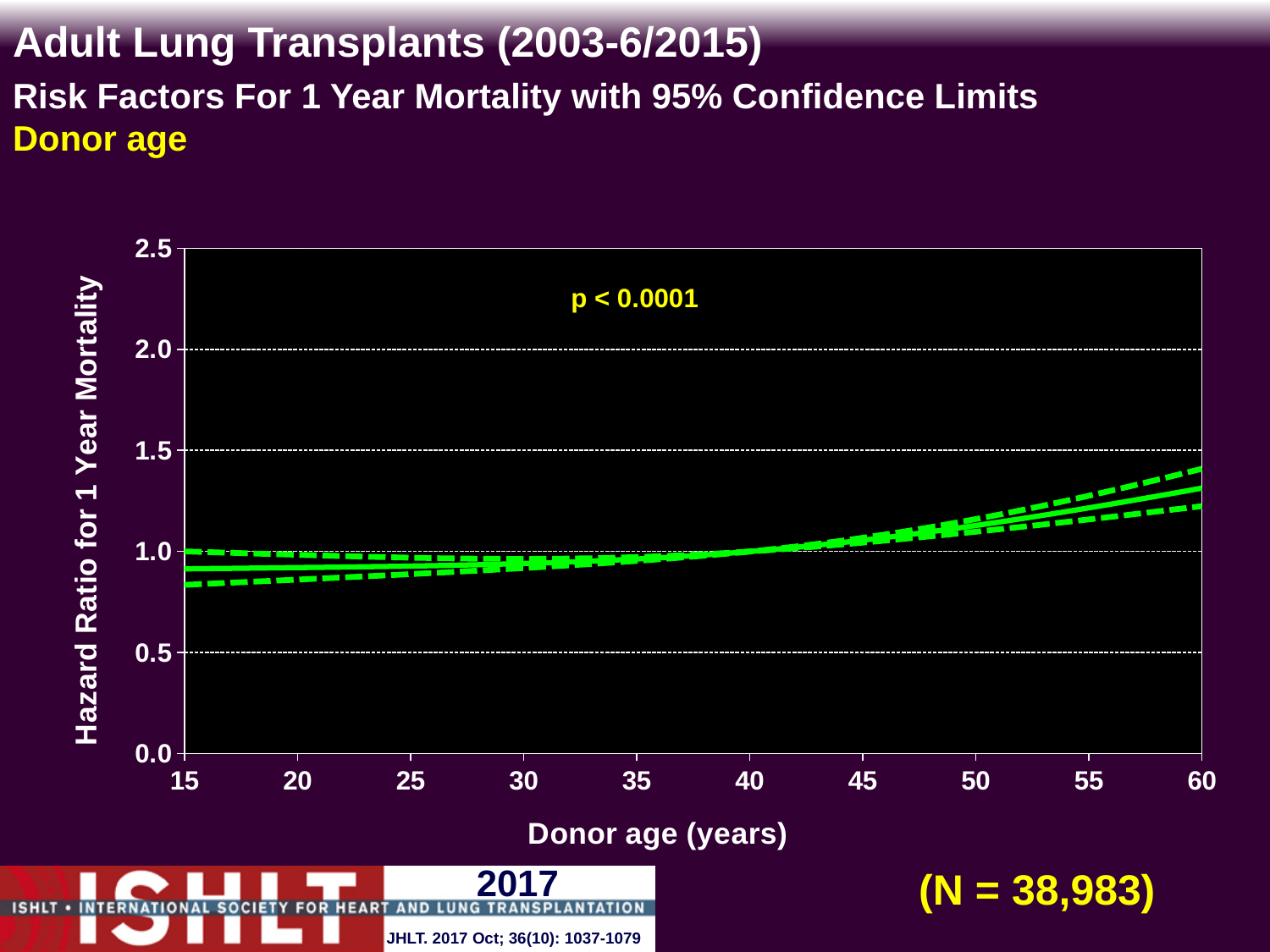
What is the label of the x axis of the chart? Donor age (years) Is the hazard ratio for 1 year mortality at a donor age of 60 years greater or less than 1.0? greater Is the hazard ratio for 1 year mortality at a donor age of 15 years greater or less than 1.0? less Does the hazard ratio for 1 year mortality rise or fall as donor age increases from 15 to 60 years? rise Is the hazard ratio for 1 year mortality at a donor age of 55 years greater or less than 1.0? greater What kind of chart is shown on the slide? line chart What p-value is printed on the chart? p < 0.0001 What is the highest value labelled on the y axis of the chart? 2.5 How many tick marks are labelled on the x axis of the chart? 10